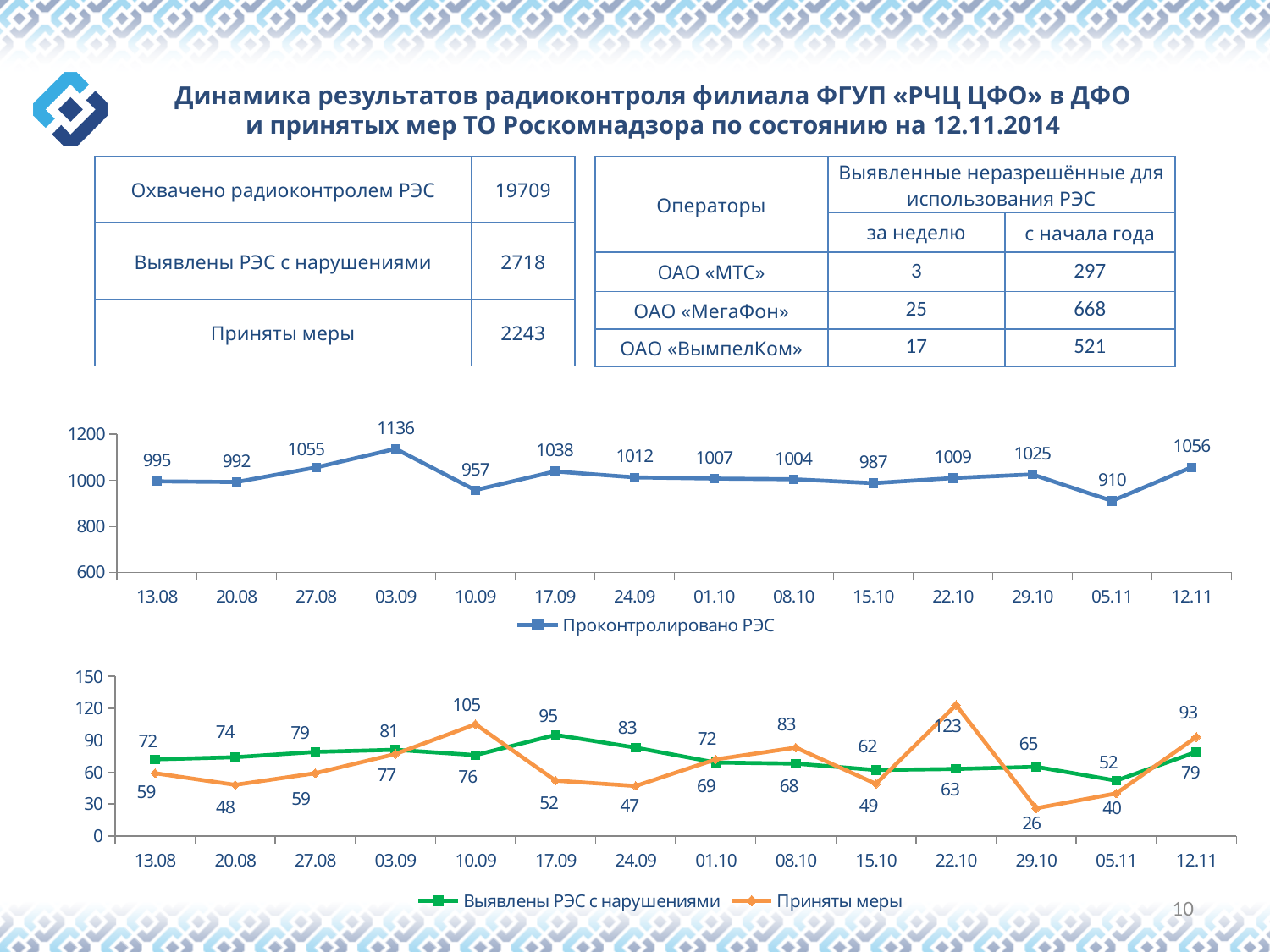
In the top chart (Проконтролировано РЭС), what is the difference between the values for 03.09 and 05.11? 226 In the top chart (Проконтролировано РЭС), what is the value for 03.09? 1136 In the top chart (Проконтролировано РЭС), how many data points are plotted? 14 In the top chart (Проконтролировано РЭС), which date has the lowest value? 05.11 In the bottom chart, which date has the lowest value for Приняты меры? 29.10 In the bottom chart, what is the value of Приняты меры for 22.10? 123 In the bottom chart, what is the difference between Выявлены РЭС с нарушениями and Приняты меры on 29.10? 39 What type of chart is the top chart (Проконтролировано РЭС)? Line chart In the bottom chart, which series has the larger value on 10.09: Выявлены РЭС с нарушениями or Приняты меры? Приняты меры In the bottom chart, what is the value of Выявлены РЭС с нарушениями for 17.09? 95 How many series does the legend of the bottom chart list? 2 In the top chart (Проконтролировано РЭС), is the value for 10.09 greater or less than 1000? less